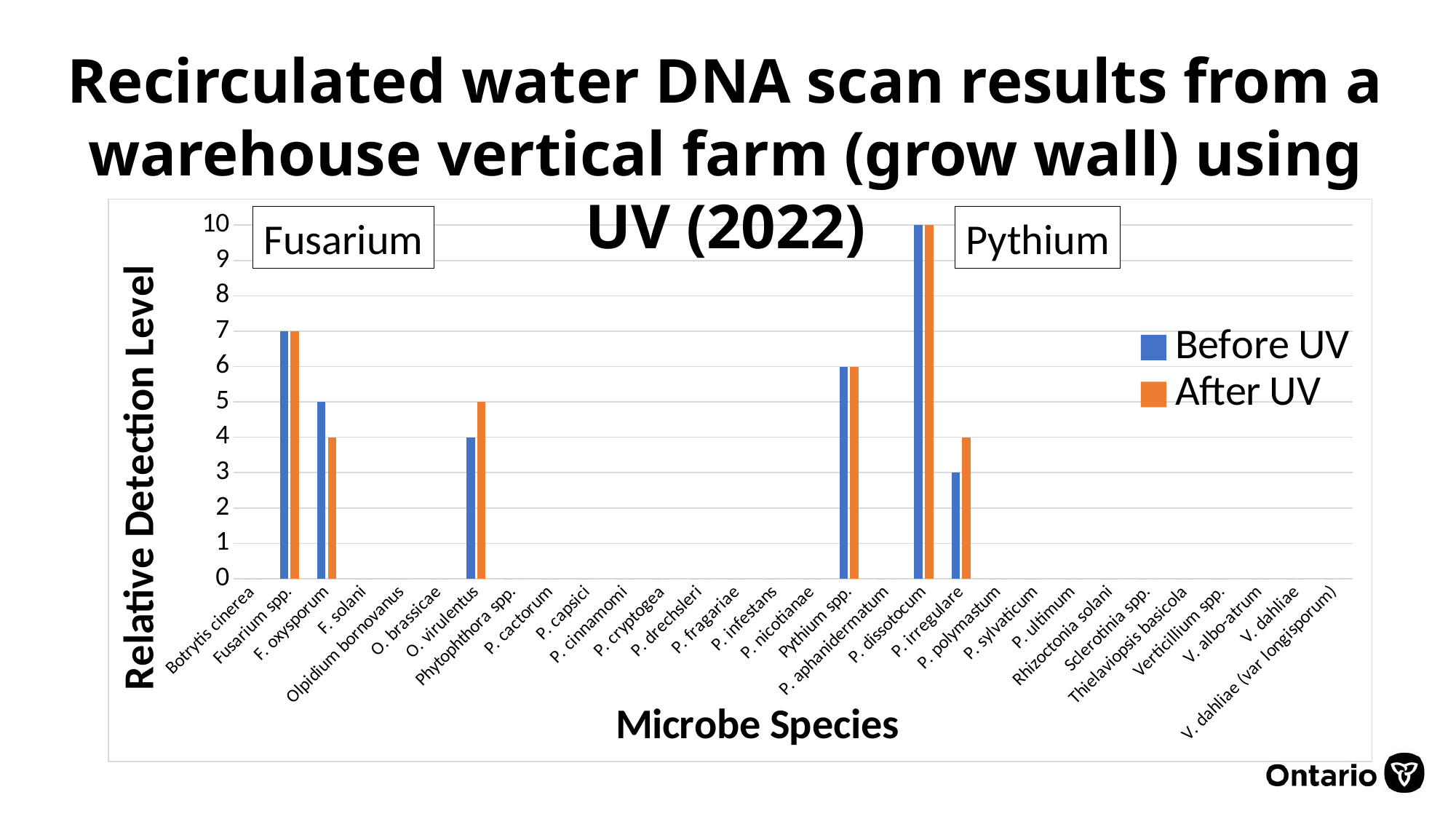
Is the Before UV value for Fusarium spp. greater or less than 5? greater How many series does the legend list? 2 How many microbe species are listed on the x axis? 30 What is the Before UV relative detection level for P. dissotocum? 10 What is the difference between the Before UV and After UV values for F. oxysporum? 1 Which is larger for O. virulentus, the Before UV value or the After UV value? After UV What is the label of the y axis? Relative Detection Level What type of chart is shown on the slide? bar chart Which microbe species has the highest Before UV detection level? P. dissotocum What is the After UV relative detection level for F. oxysporum? 4 What is the After UV relative detection level for P. irregulare? 4 What is the Before UV relative detection level for Pythium spp.? 6